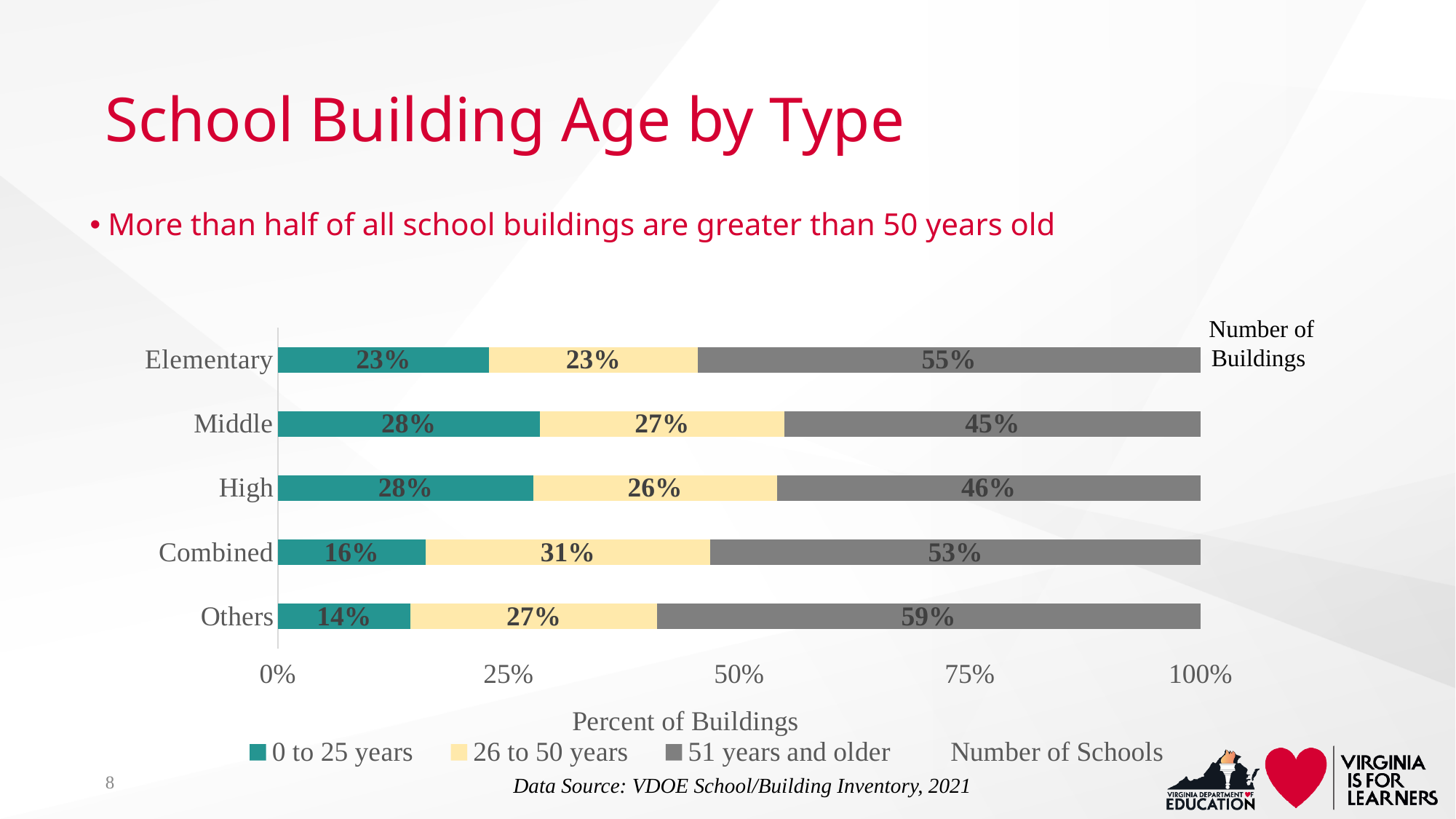
What percentage of Elementary school buildings are 51 years and older? 55% How many school types are shown on the chart? 5 What kind of chart is shown on the slide? Stacked bar chart What is the difference between the 51 years and older percentage for Others and for Elementary? 4 percentage points How many entries does the legend list? 4 Which colour represents the 26 to 50 years series? Yellow What percentage of Others school buildings are 0 to 25 years old? 14% Which has a larger share of buildings 0 to 25 years old, Middle or Combined? Middle Which school type has the lowest percentage of buildings 0 to 25 years old? Others Which school type has the highest percentage of buildings 51 years and older? Others What is the label of the x axis? Percent of Buildings What percentage of Combined school buildings are 26 to 50 years old? 31%